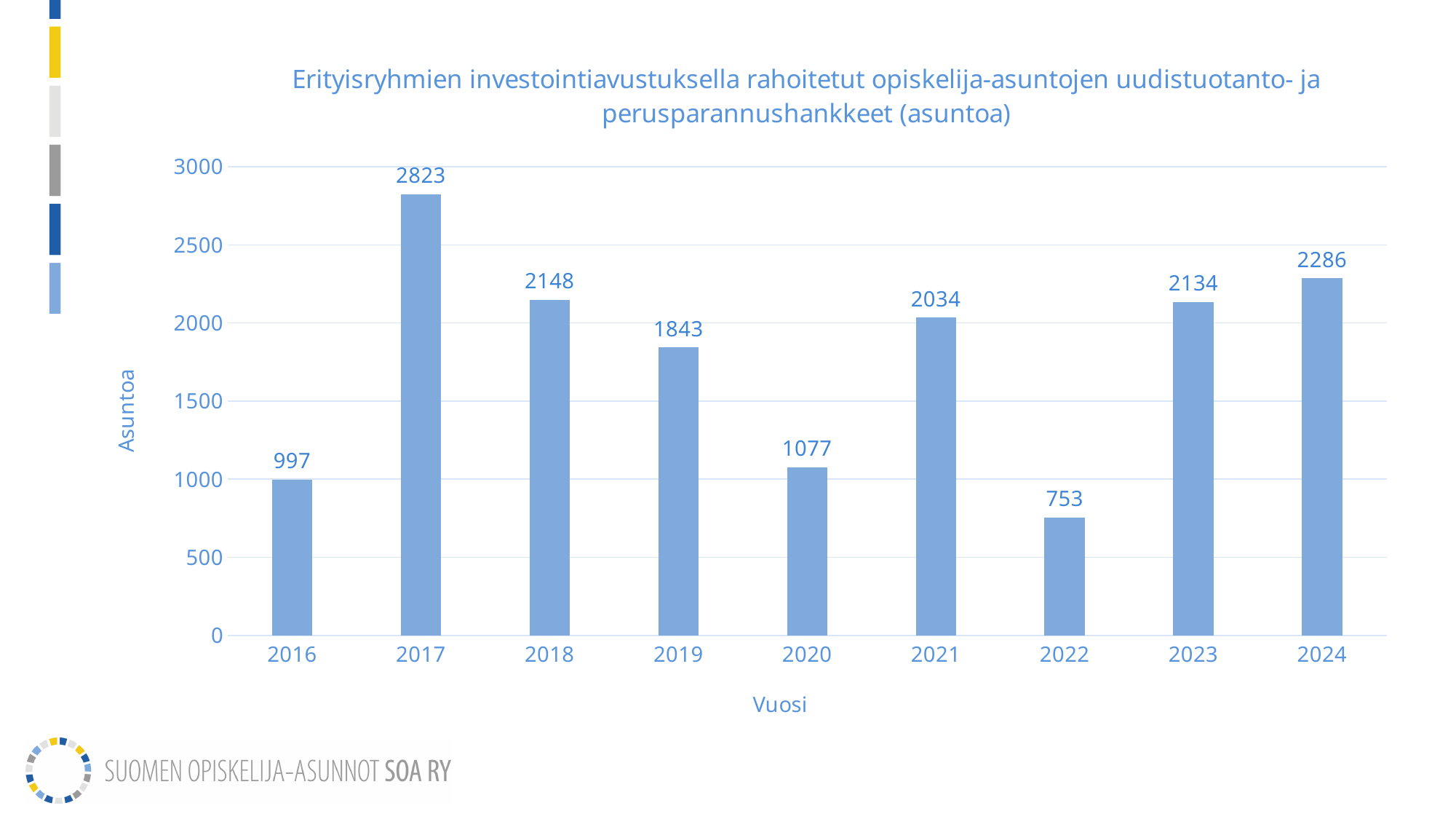
Which is larger, the value for 2018 or the value for 2019? 2018 What is the value for 2017? 2823 What is the difference between the values for 2017 and 2016? 1826 What kind of chart is shown on the slide? bar chart What is the value for 2022? 753 What is the value for 2024? 2286 Which year has the lowest value? 2022 What is the difference between the values for 2024 and 2023? 152 Is the value for 2020 greater or less than 1500? less Which year has the highest value? 2017 How many years are shown on the x axis? 9 What is the label of the y axis? Asuntoa